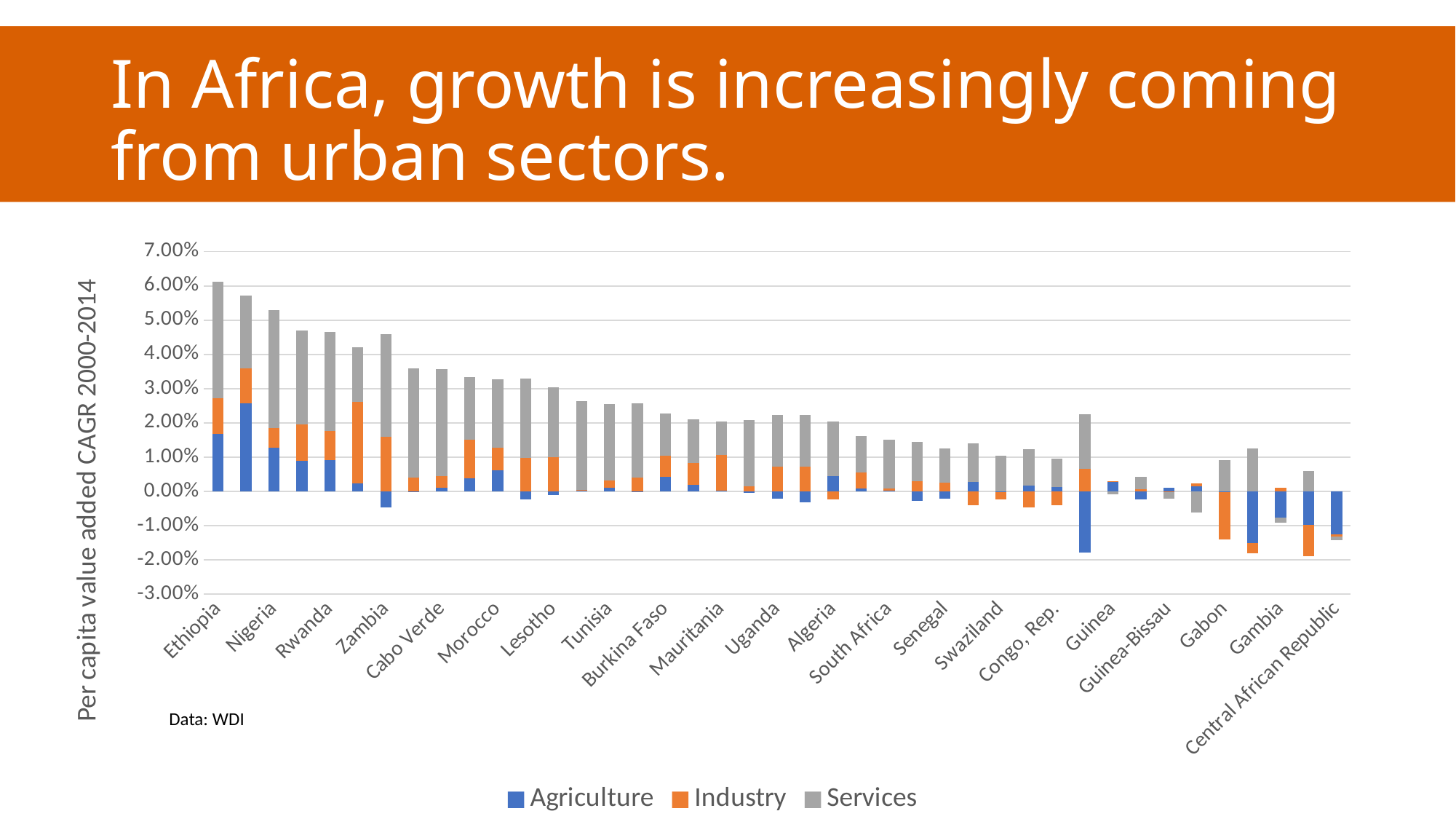
Which has the larger total stacked value, Ethiopia or Nigeria? Ethiopia Is the Industry value for Gabon greater or less than -1.00%? less What is the label on the vertical axis? Per capita value added CAGR 2000-2014 Is the Agriculture value for Nigeria greater or less than 2.00%? less Is the total stacked value for Ethiopia greater or less than 5.00%? greater Do the total stacked values generally rise or fall moving from left to right along the x axis? fall How many series does the legend list? 3 What are the three series named in the legend? Agriculture, Industry, Services Which has the larger Agriculture value, Nigeria or Ethiopia? Ethiopia What kind of chart is shown on the slide? Stacked bar chart Which labelled country has the tallest stacked bar? Ethiopia